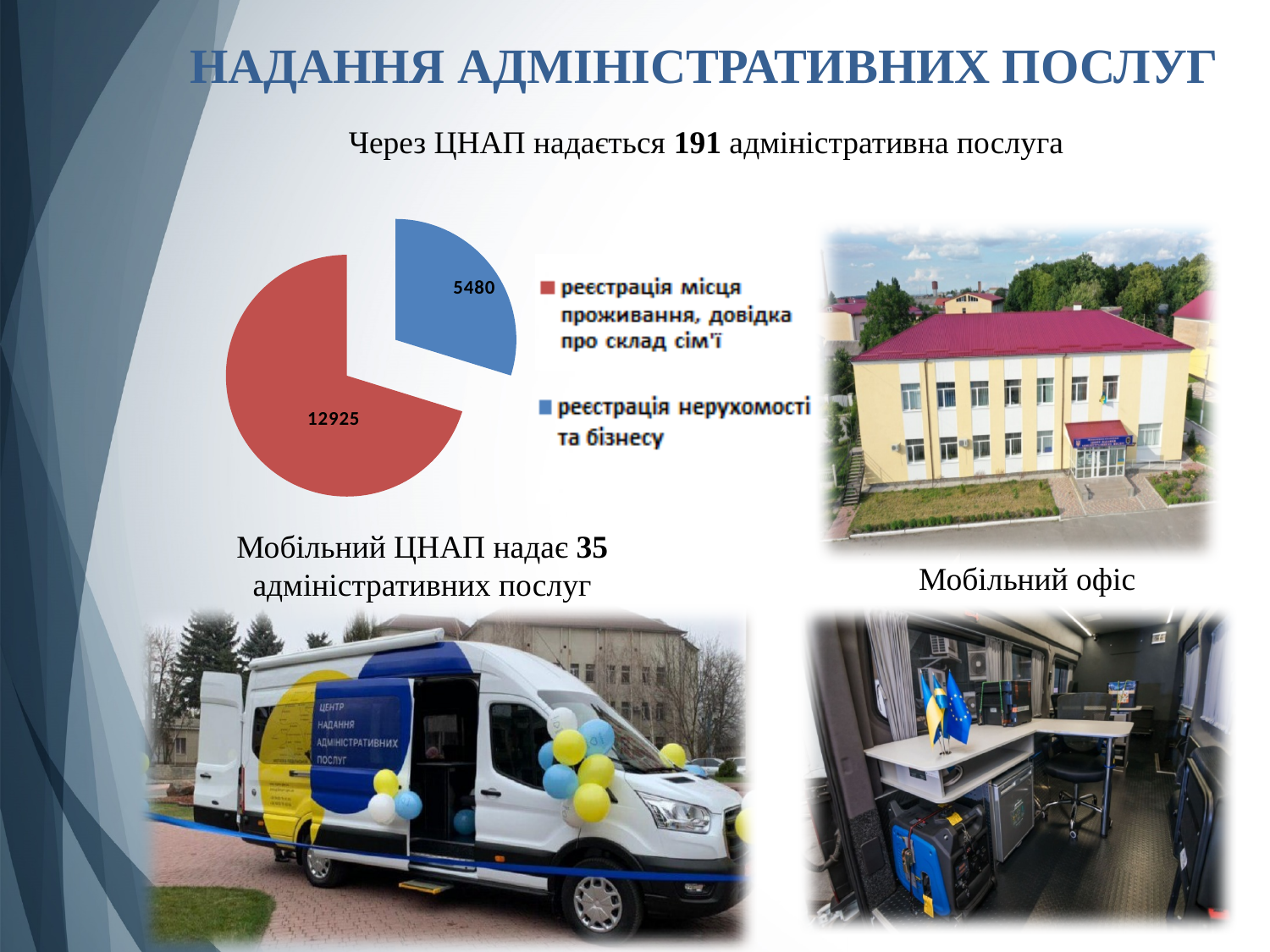
What is the total of the two values shown in the pie chart? 18405 What share of the pie does "реєстрація нерухомості та бізнесу" represent, to the nearest percent? 30% What is the value for "реєстрація нерухомості та бізнесу" in the pie chart? 5480 What is the value for "реєстрація місця проживання, довідка про склад сім'ї" in the pie chart? 12925 How many slices does the pie chart have? 2 What is the difference between the two slice values in the pie chart? 7445 What type of chart is shown on the slide? pie chart Which category has the smallest slice in the pie chart? реєстрація нерухомості та бізнесу What colour is the slice for "реєстрація нерухомості та бізнесу" in the pie chart? blue Which category has the largest slice in the pie chart? реєстрація місця проживання, довідка про склад сім'ї How many entries does the legend of the pie chart list? 2 Which is larger: the value for "реєстрація місця проживання, довідка про склад сім'ї" or for "реєстрація нерухомості та бізнесу"? реєстрація місця проживання, довідка про склад сім'ї